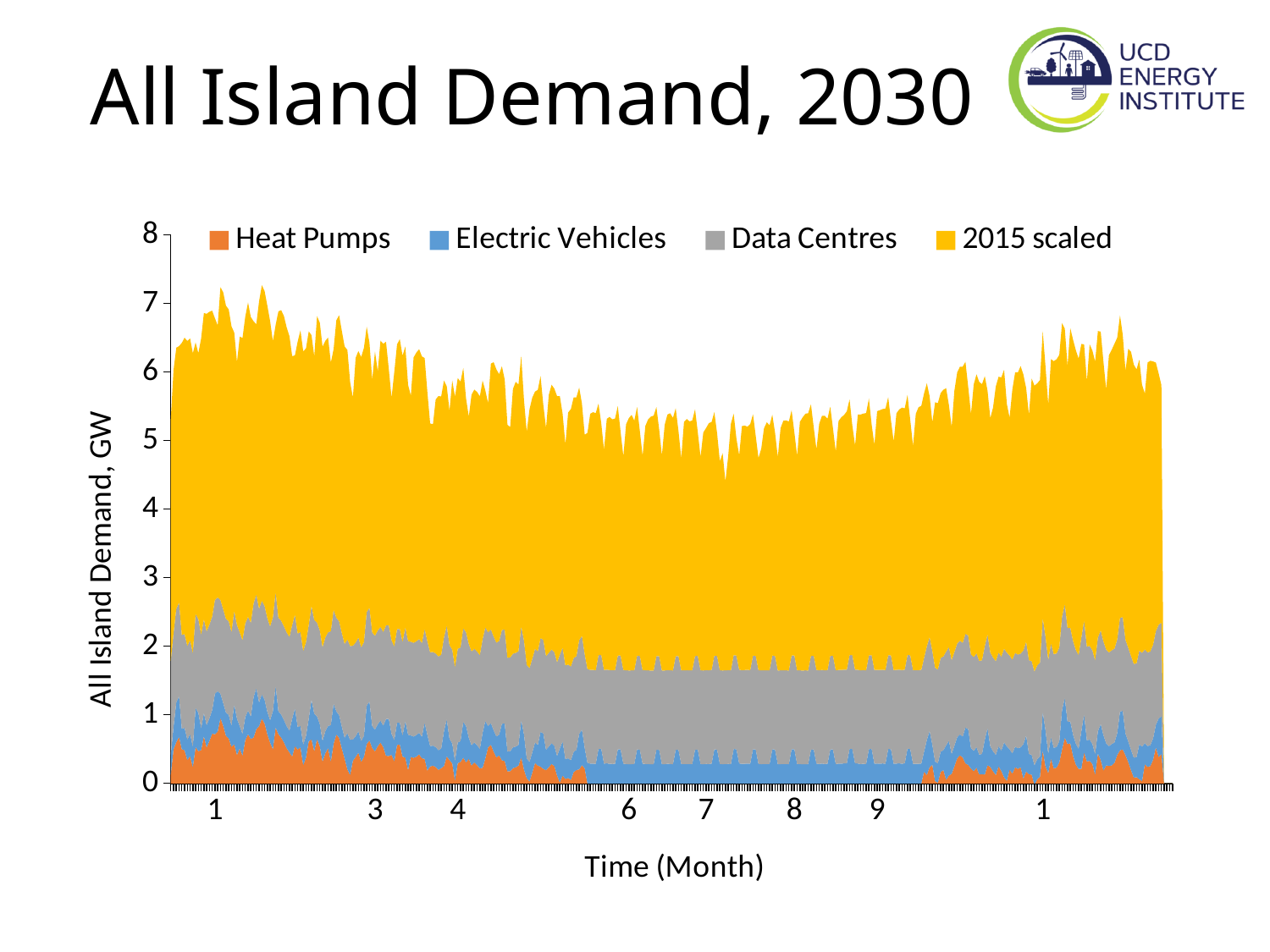
Is the lowest total demand shown greater or less than 4 GW? greater Does total demand rise or fall from month 1 to month 7? fall What is the title of the chart? All Island Demand, 2030 Which series contributes the largest share of total demand throughout the year? 2015 scaled How many series does the legend list? 4 Is the total demand around month 1 greater or less than the total demand around month 7? greater What are the four series listed in the legend? Heat Pumps, Electric Vehicles, Data Centres, 2015 scaled What kind of chart is shown on the slide? Stacked area chart Which series is at the bottom of the stack? Heat Pumps Is the peak total demand in the first two months greater or less than 7 GW? greater Is the Heat Pumps demand around month 7 greater or less than 1 GW? less